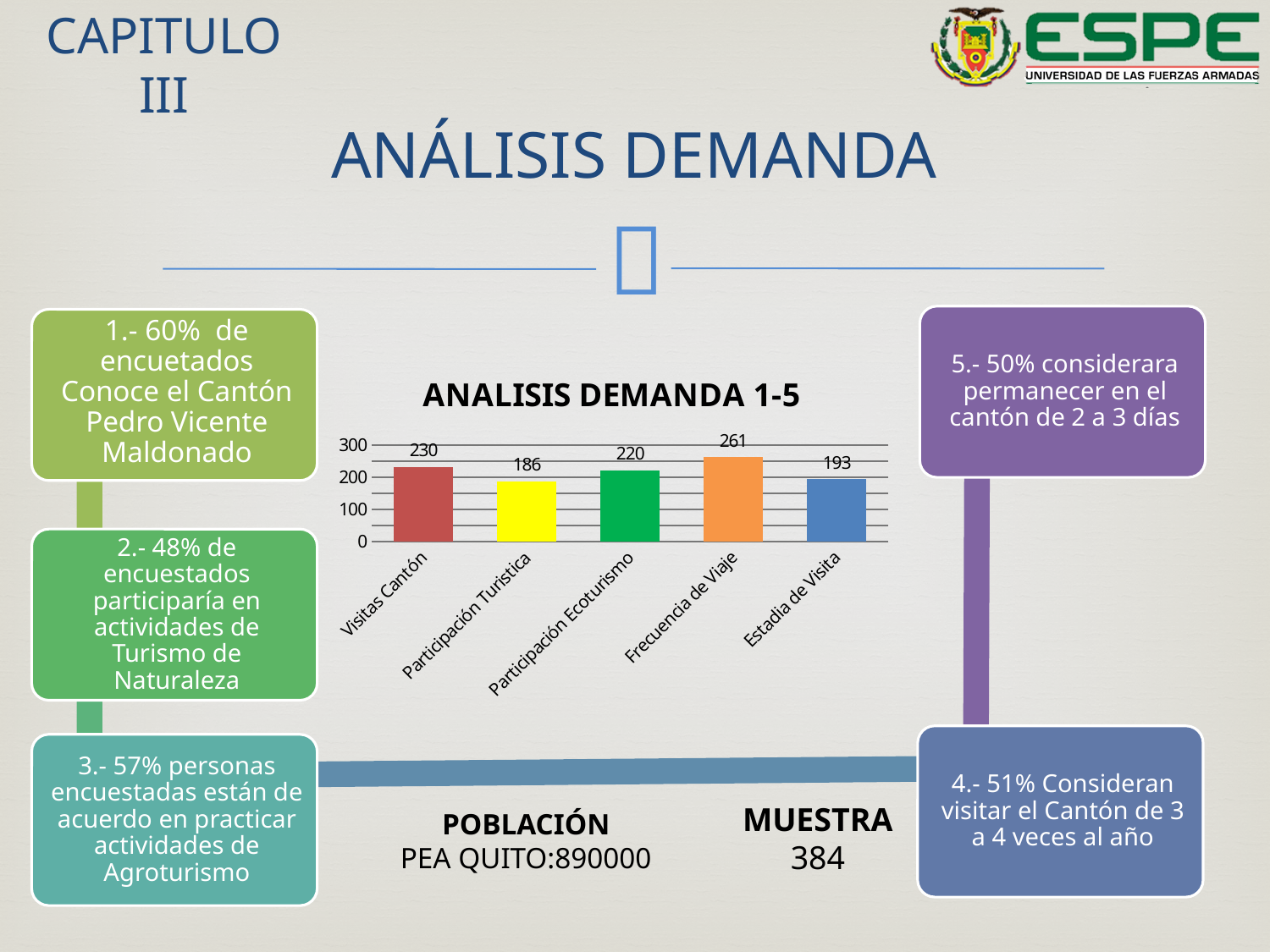
What kind of chart is shown on the slide? Bar chart Is the value for Participación Ecoturismo greater or less than 200? greater How many categories are shown in the chart? 5 What is the title of the chart? ANALISIS DEMANDA 1-5 What is the value for Participación Turistica? 186 What is the difference between Frecuencia de Viaje and Participación Turistica? 75 Which category has the highest value? Frecuencia de Viaje What is the value for Estadia de Visita? 193 What is the value for Frecuencia de Viaje? 261 Which is larger, Visitas Cantón or Participación Ecoturismo? Visitas Cantón What is the value for Visitas Cantón in the chart? 230 Which category has the lowest value? Participación Turistica